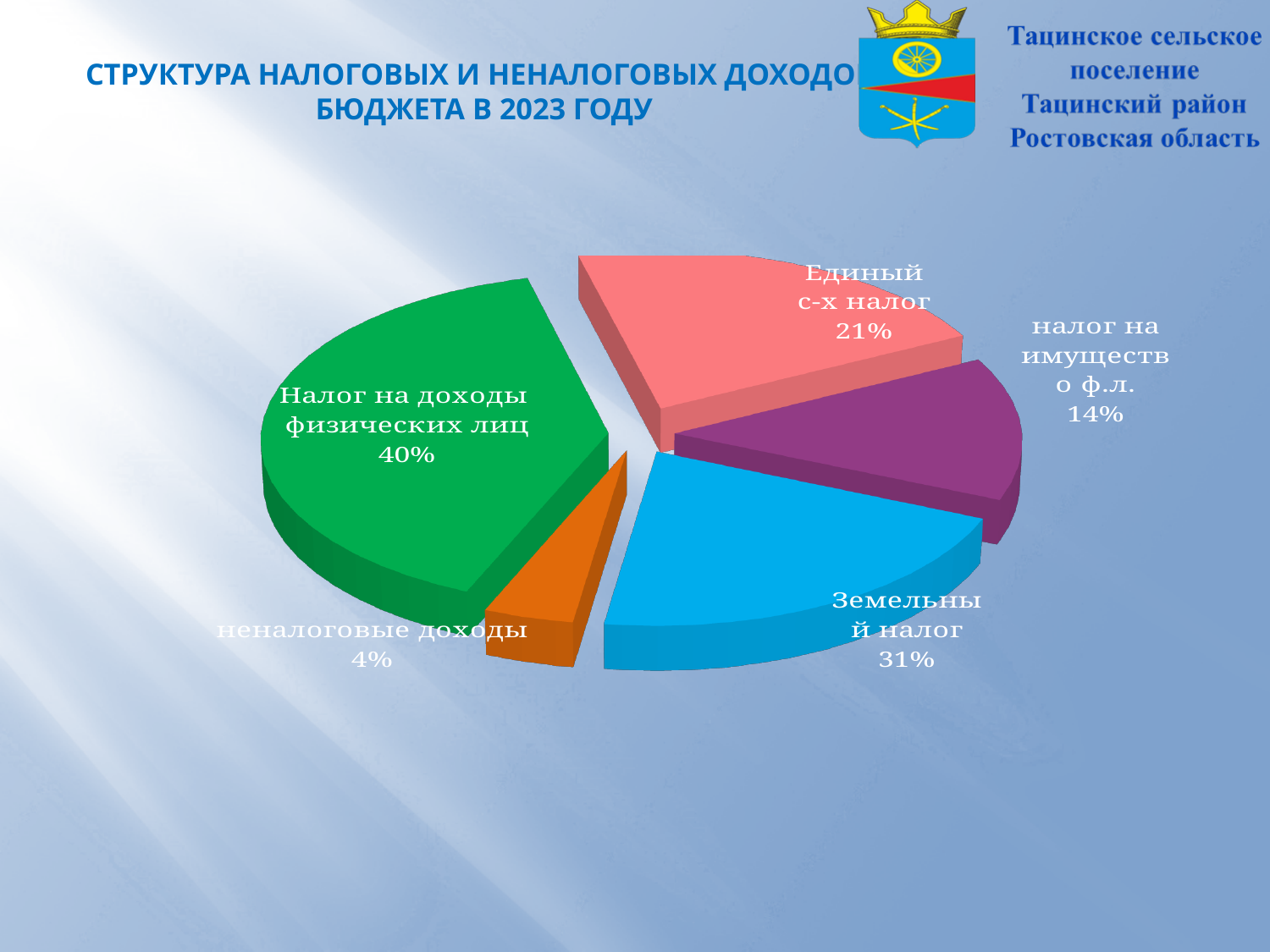
Which category has the largest slice of the pie? Налог на доходы физических лиц Which category has the smallest slice of the pie? неналоговые доходы What is the value shown for неналоговые доходы? 4% What is the difference between the shares of Налог на доходы физических лиц and Земельный налог? 9% What is the value shown for налог на имущество ф.л.? 14% What share of the pie does Налог на доходы физических лиц have? 40% What colour is the slice for Земельный налог? Blue What is the value shown for Земельный налог? 31% What is the value shown for Единый с-х налог? 21% Which is larger, Единый с-х налог or налог на имущество ф.л.? Единый с-х налог What kind of chart is shown on the slide? Pie chart How many slices does the pie chart have? 5